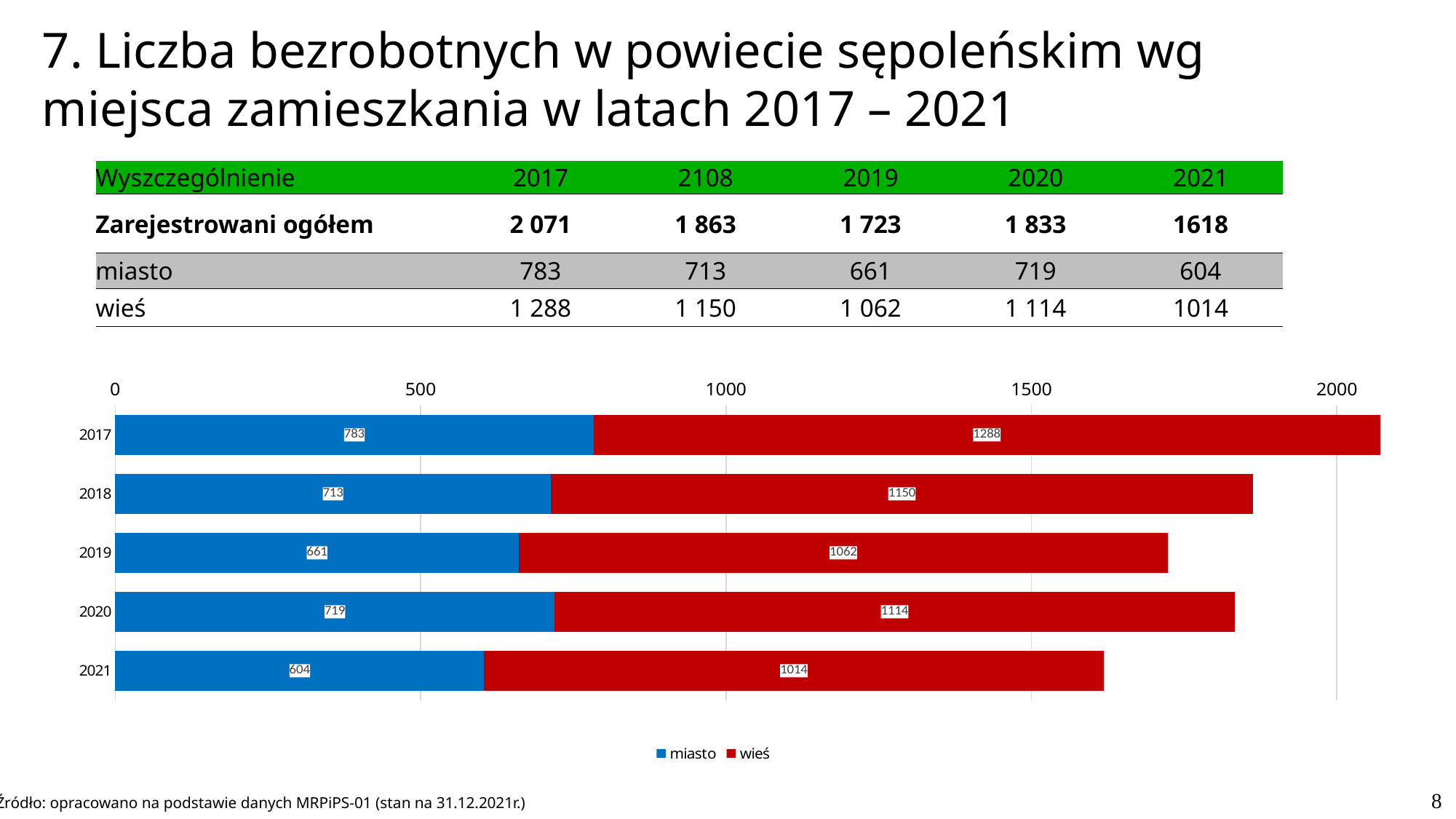
What is the value for wieś in 2019? 1062 How many years are shown on the chart? 5 Which year has the highest value for wieś? 2017 What kind of chart is shown on the slide? stacked bar chart What is the difference between the wieś values for 2017 and 2018? 138 What is the value for miasto in 2017? 783 Which year has the lowest value for miasto? 2021 Which is larger, the miasto value for 2019 or for 2020? 2020 How many series does the legend list? 2 What is the total of the stacked bar for 2019? 1723 What is the value for wieś in 2021? 1014 What is the total of the stacked bar for 2021? 1618